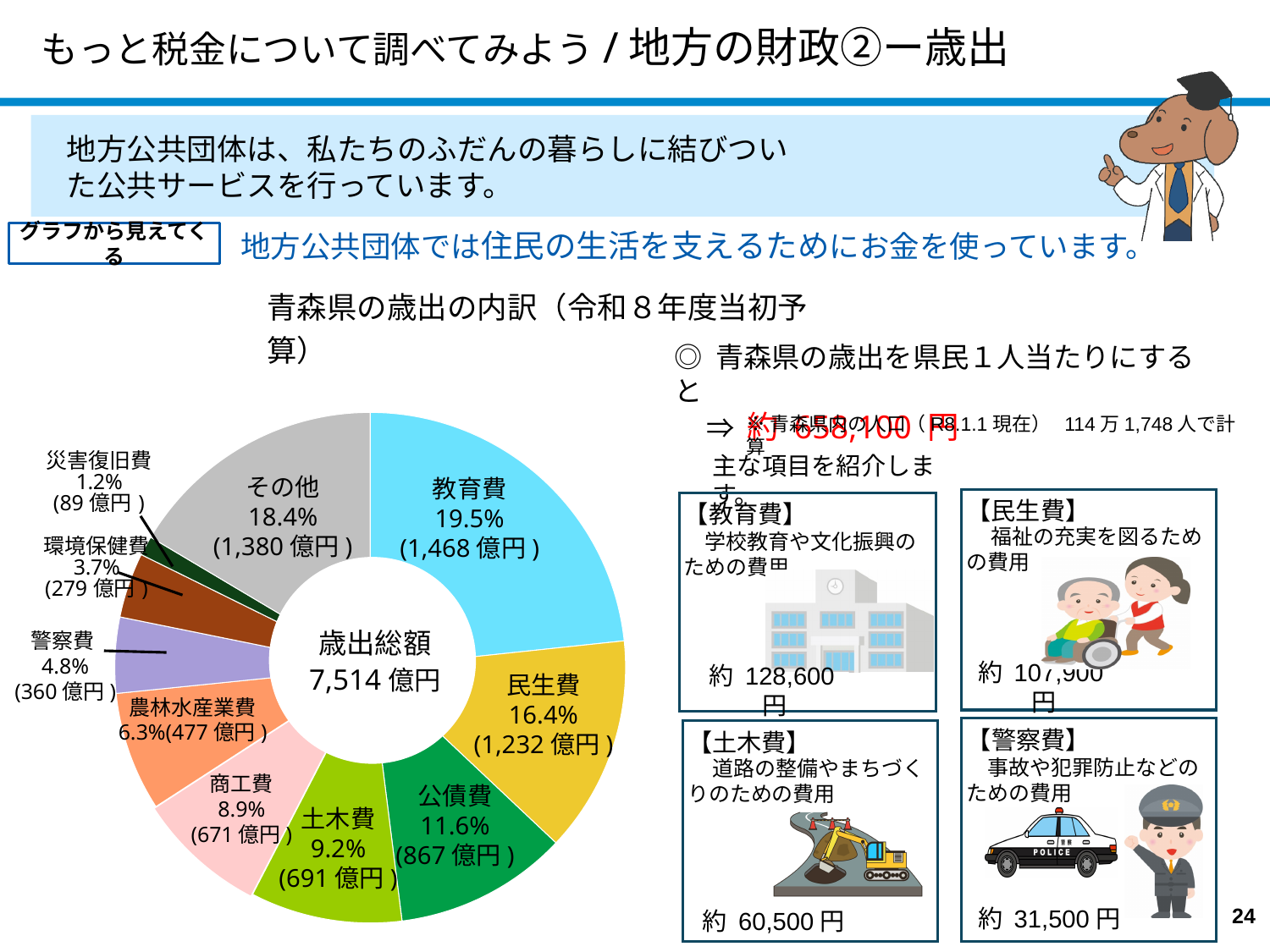
歳出総額はいくらですか。 7,514億円 グラフのタイトルは何ですか。 青森県の歳出の内訳（令和８年度当初予算） 教育費と民生費の金額の差はいくらですか。 236億円 「その他」を除いて、割合が最も大きい項目はどれですか。 教育費 公債費の割合は何％ですか。 11.6% 土木費と商工費では、どちらの割合が大きいですか。 土木費 このグラフはどの種類のグラフですか。 円グラフ（ドーナツグラフ） 教育費の割合は何％ですか。 19.5% グラフには項目がいくつありますか。 10 警察費の金額はいくらですか。 360億円 割合が最も小さい項目はどれですか。 災害復旧費 民生費の金額はいくらですか。 1,232億円